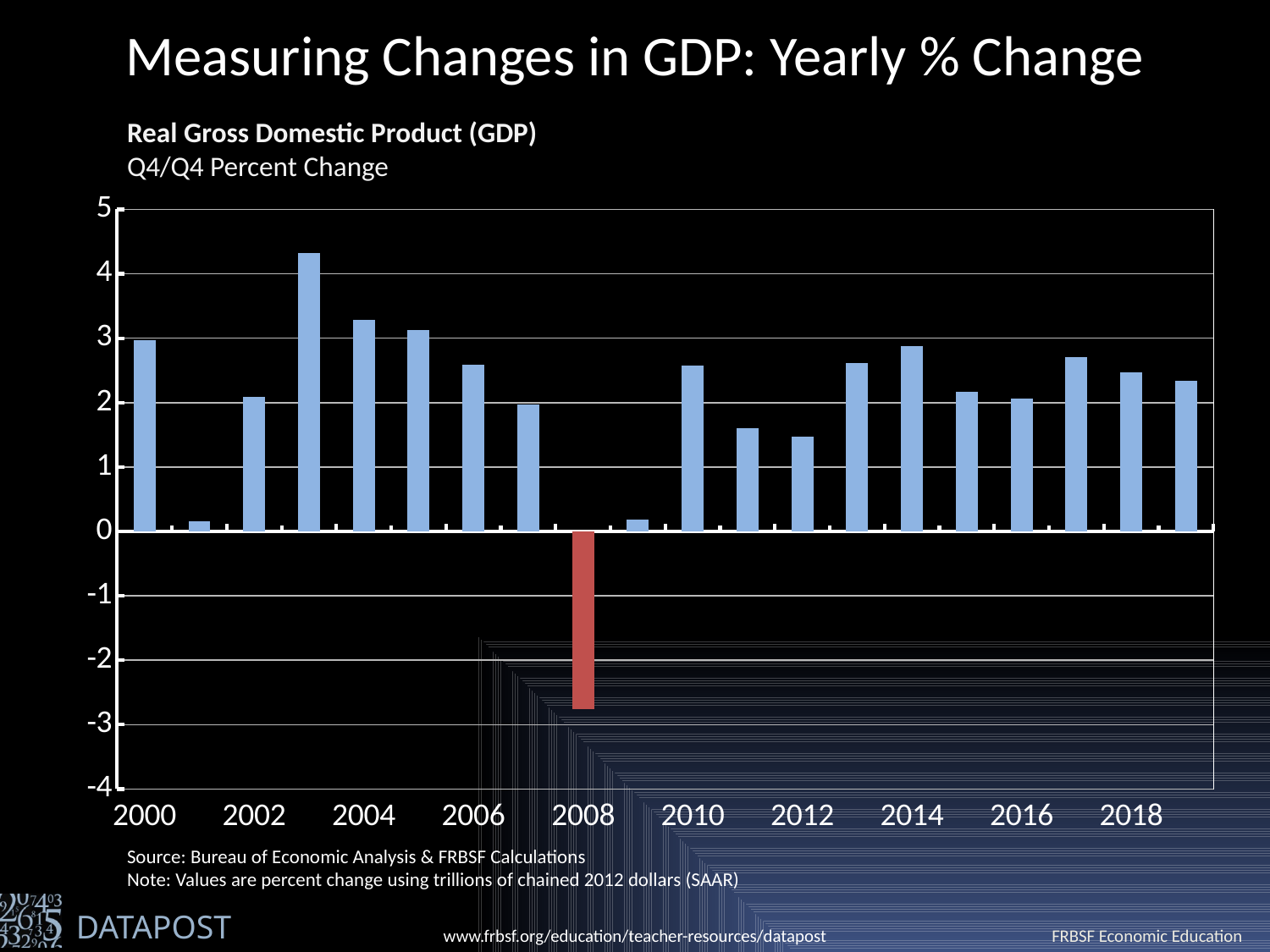
What colour is the bar for 2008? red Is the value for 2004 greater or less than 2? greater What kind of chart is shown on the slide? bar chart What is the title printed above the chart? Real Gross Domestic Product (GDP) Which year has the lowest (only negative) value in the chart? 2008 Is the value for 2012 greater or less than 2? less Is the value for 2014 greater or less than 2? greater Which year has the larger value, 2002 or 2008? 2002 How many yearly bars are plotted in the chart? 20 Which year has the larger value, 2000 or 2012? 2000